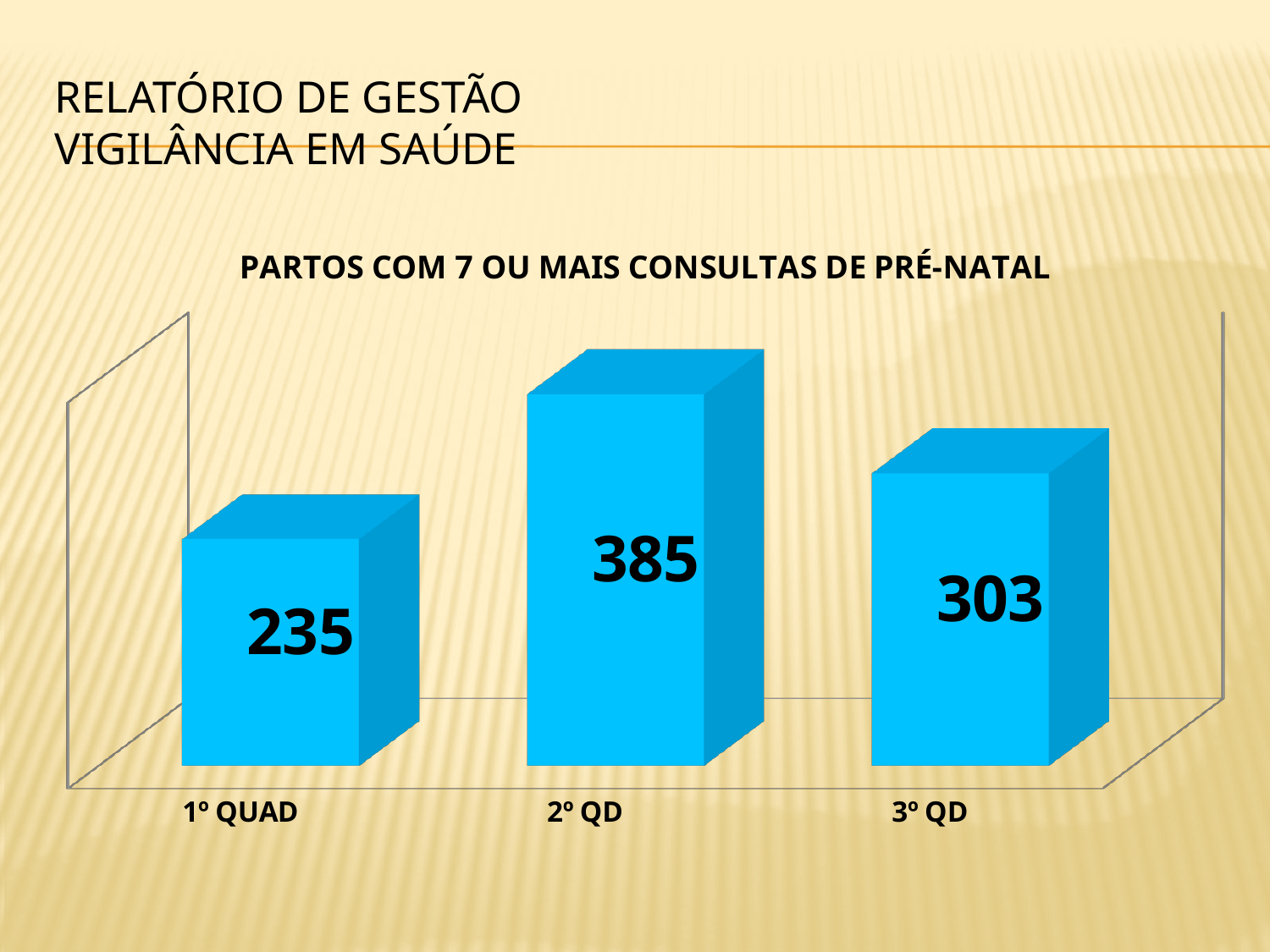
What is the value for 3º QD? 303 What colour are the bars in the chart? blue What is the difference between the values for 2º QD and 1º QUAD? 150 What is the title of the chart? PARTOS COM 7 OU MAIS CONSULTAS DE PRÉ-NATAL What is the value for 1º QUAD? 235 Which category has the highest value? 2º QD What is the value for 2º QD? 385 How many categories are shown in the chart? 3 What is the difference between the values for 2º QD and 3º QD? 82 Which category has the lowest value? 1º QUAD What kind of chart is shown on the slide? bar chart Which is larger, the value for 3º QD or the value for 1º QUAD? 3º QD